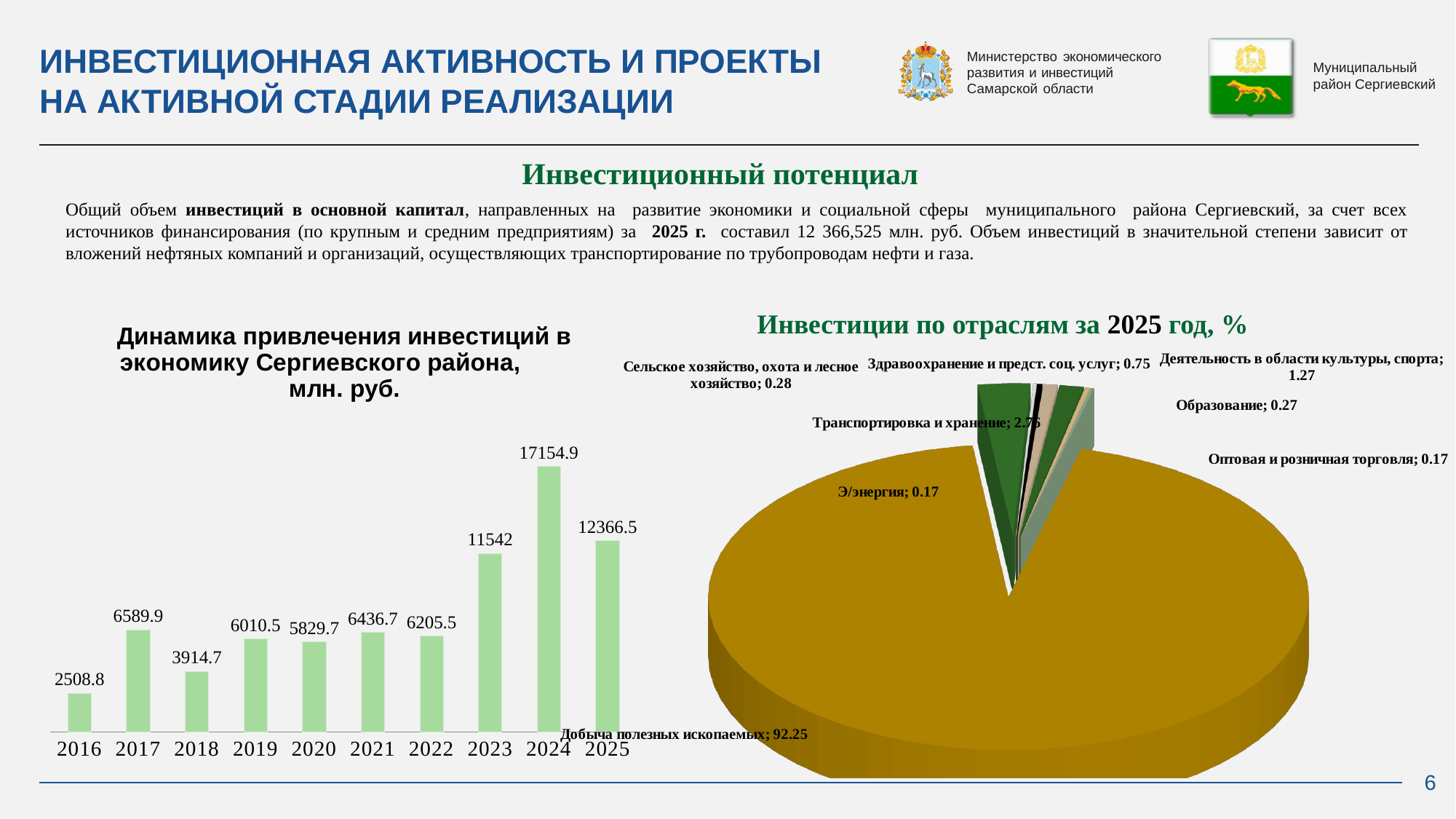
In the bar chart 'Динамика привлечения инвестиций в экономику Сергиевского района, млн. руб.', does the value rise or fall from 2022 to 2024? rise How many years are shown in the bar chart 'Динамика привлечения инвестиций в экономику Сергиевского района, млн. руб.'? 10 In the bar chart 'Динамика привлечения инвестиций в экономику Сергиевского района, млн. руб.', what is the difference between the values for 2024 and 2025? 4788.4 In the bar chart 'Динамика привлечения инвестиций в экономику Сергиевского района, млн. руб.', which year has the highest value? 2024 In the pie chart 'Инвестиции по отраслям за 2025 год, %', what is the share for Добыча полезных ископаемых? 92.25 In the bar chart 'Динамика привлечения инвестиций в экономику Сергиевского района, млн. руб.', what is the value for 2016? 2508.8 In the bar chart 'Динамика привлечения инвестиций в экономику Сергиевского района, млн. руб.', what is the value for 2025? 12366.5 What kind of chart is 'Динамика привлечения инвестиций в экономику Сергиевского района, млн. руб.'? bar chart In the pie chart 'Инвестиции по отраслям за 2025 год, %', what is the value for Деятельность в области культуры, спорта? 1.27 In the bar chart 'Динамика привлечения инвестиций в экономику Сергиевского района, млн. руб.', which is larger, the value for 2017 or the value for 2018? 2017 In the bar chart 'Динамика привлечения инвестиций в экономику Сергиевского района, млн. руб.', which year has the lowest value? 2016 What kind of chart is 'Инвестиции по отраслям за 2025 год, %'? pie chart